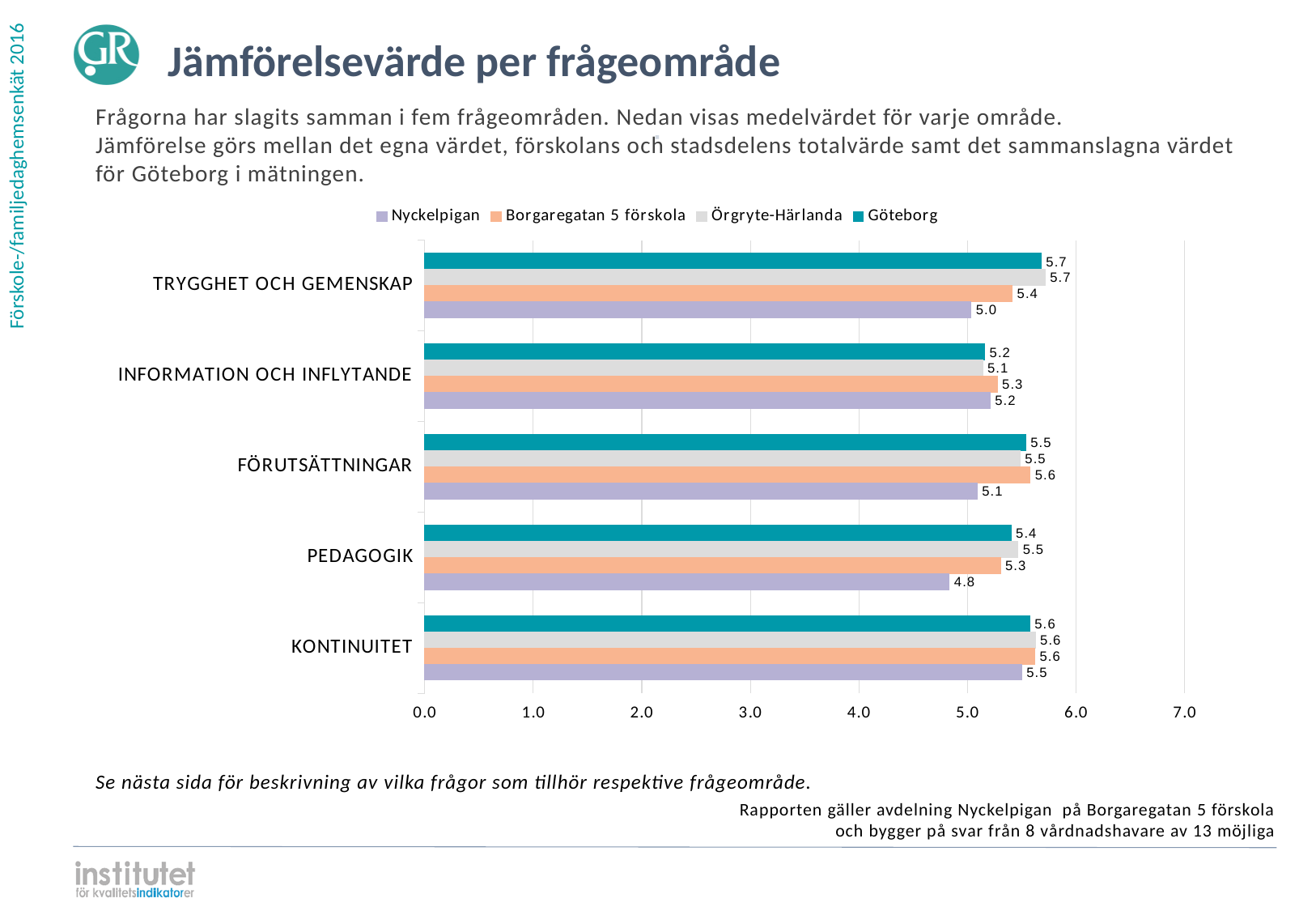
What is the value for Nyckelpigan in the PEDAGOGIK category? 4.8 What kind of chart is shown on the slide? Bar chart In which category does Nyckelpigan have its lowest value? PEDAGOGIK What is the title of the slide? Jämförelsevärde per frågeområde What is the value for Göteborg in the TRYGGHET OCH GEMENSKAP category? 5.7 How many series does the legend list? 4 In which category does Nyckelpigan have its highest value? KONTINUITET How many question areas (categories) are shown on the chart? 5 What is the value for Örgryte-Härlanda in the INFORMATION OCH INFLYTANDE category? 5.1 What is the value for Borgaregatan 5 förskola in the FÖRUTSÄTTNINGAR category? 5.6 In the TRYGGHET OCH GEMENSKAP category, what is the difference between the Göteborg value and the Nyckelpigan value? 0.7 In the PEDAGOGIK category, which is larger: the value for Örgryte-Härlanda or the value for Borgaregatan 5 förskola? Örgryte-Härlanda